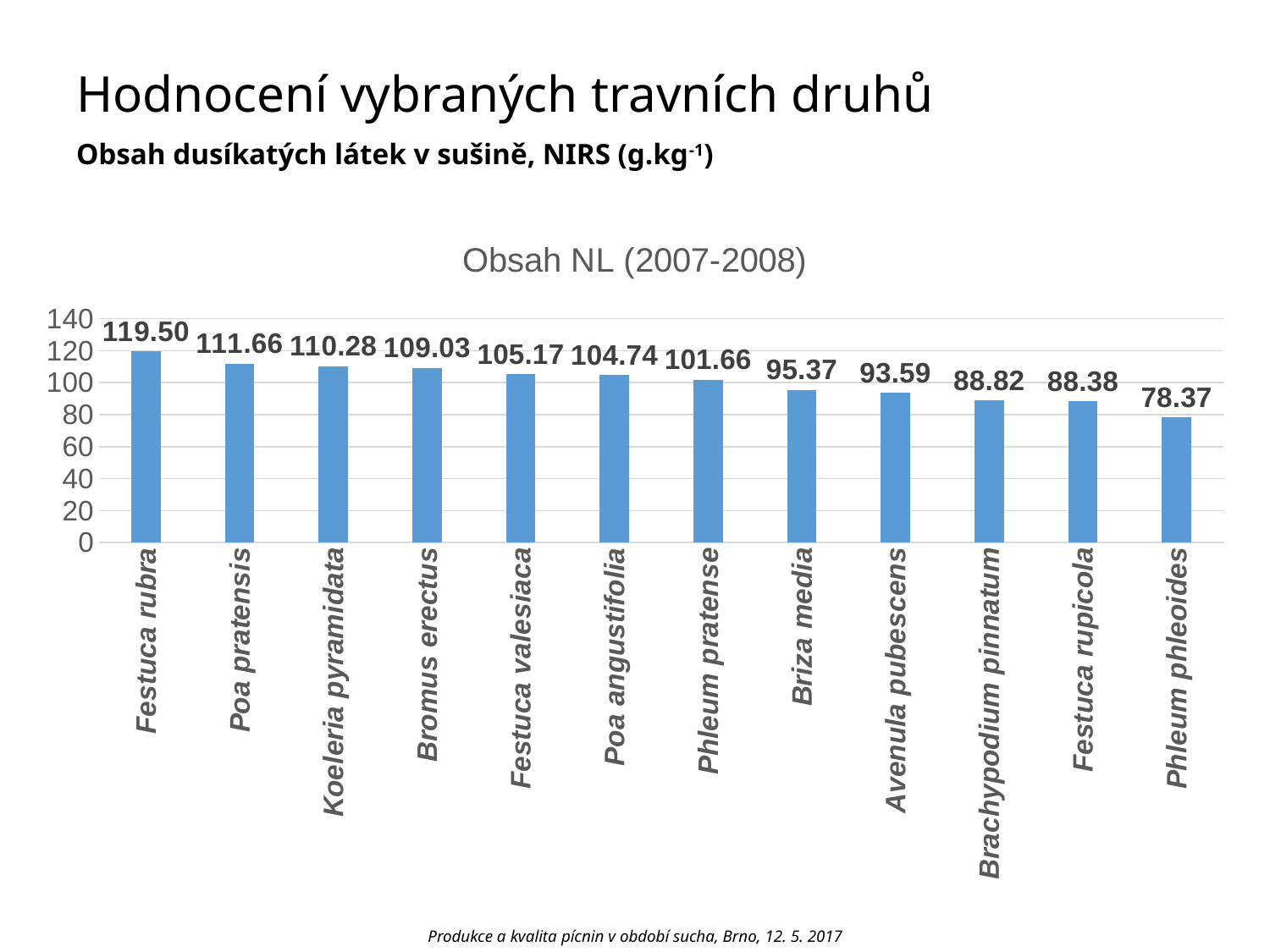
What is the difference between the values for Poa pratensis and Briza media? 16.29 What is the value for Festuca rubra? 119.50 Which category has the highest value? Festuca rubra Which category has the lowest value? Phleum phleoides What is the value for Briza media? 95.37 How many categories are shown in the chart? 12 What is the difference between the values for Festuca rubra and Phleum phleoides? 41.13 What kind of chart is shown on the slide? bar chart Which is larger, the value for Bromus erectus or the value for Avenula pubescens? Bromus erectus What is the value for Phleum phleoides? 78.37 What is the title of the chart? Obsah NL (2007-2008) Is the value for Phleum pratense greater or less than 100? greater